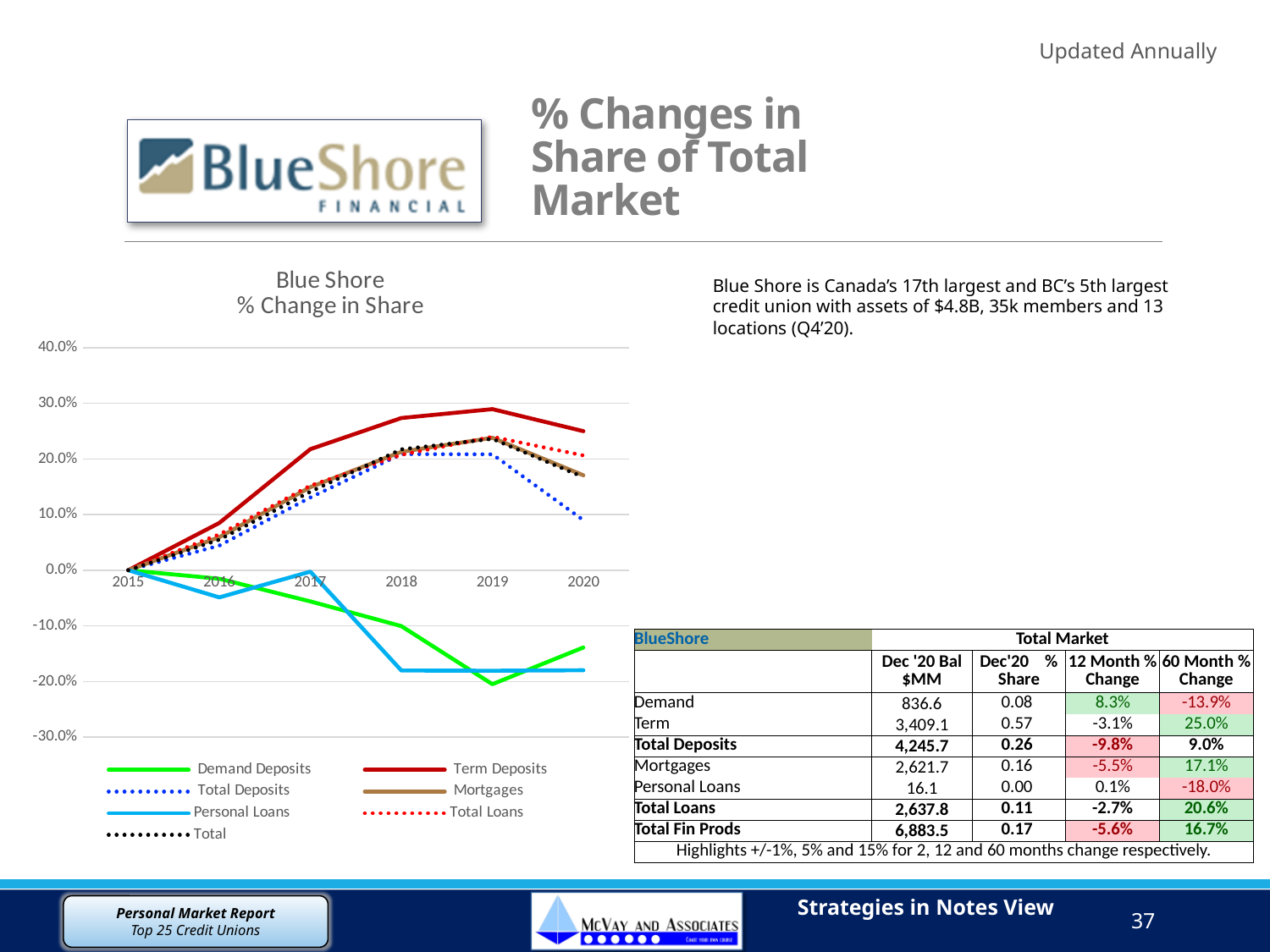
In the 'Blue Shore % Change in Share' chart, which is larger in 2020: Term Deposits or Personal Loans? Term Deposits In the 'Blue Shore % Change in Share' chart, is the value for Demand Deposits in 2019 greater or less than -10.0%? less In the 'Blue Shore % Change in Share' chart, what is the value for Term Deposits in 2015? 0.0% In the 'Blue Shore % Change in Share' chart, which series has the highest value in 2020? Term Deposits How many years are shown on the x axis of the 'Blue Shore % Change in Share' chart? 6 What kind of chart is the 'Blue Shore % Change in Share' chart? line chart In the 'Blue Shore % Change in Share' chart, is the value for Personal Loans in 2018 greater or less than -10.0%? less In the 'Blue Shore % Change in Share' chart, which series has the lowest value in 2018? Personal Loans How many series does the legend of the 'Blue Shore % Change in Share' chart list? 7 In the 'Blue Shore % Change in Share' chart, is the value for Term Deposits in 2019 greater or less than 20.0%? greater In the 'Blue Shore % Change in Share' chart, does the Term Deposits series rise or fall from 2015 to 2019? rise In the 'Blue Shore % Change in Share' chart, what colour is the Demand Deposits line? green